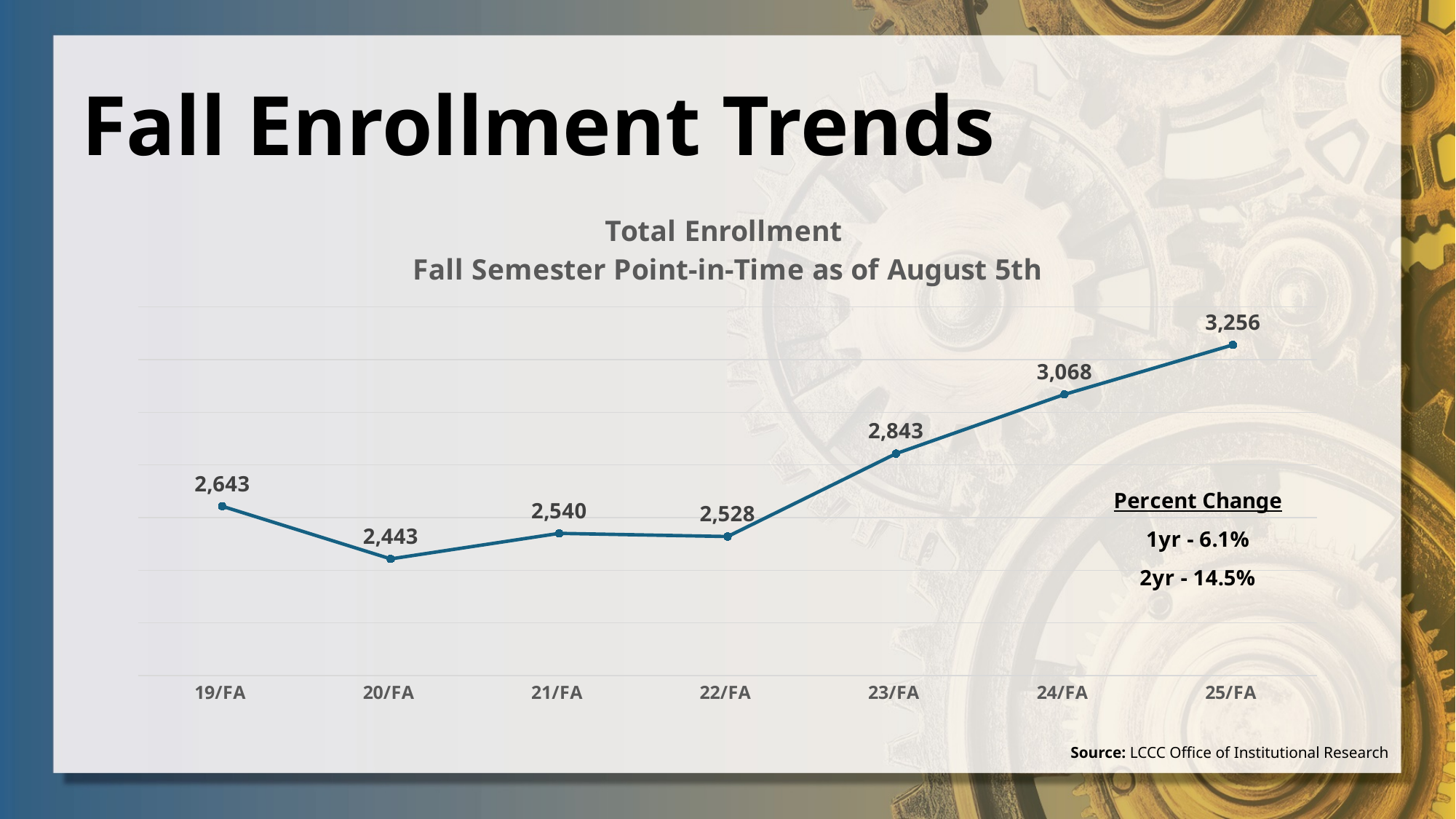
Which fall semester has the highest total enrollment? 25/FA Which has the higher total enrollment, 21/FA or 22/FA? 21/FA What is the total enrollment for 22/FA? 2,528 Which fall semester has the lowest total enrollment? 20/FA What is the 2-year percent change shown on the chart? 14.5% How many fall semesters are plotted on the chart? 7 What kind of chart is shown on the slide? Line chart What is the difference in total enrollment between 19/FA and 20/FA? 200 What is the difference in total enrollment between 25/FA and 24/FA? 188 What is the total enrollment for 25/FA? 3,256 Does total enrollment rise or fall from 22/FA to 25/FA? Rise What is the total enrollment for 20/FA? 2,443